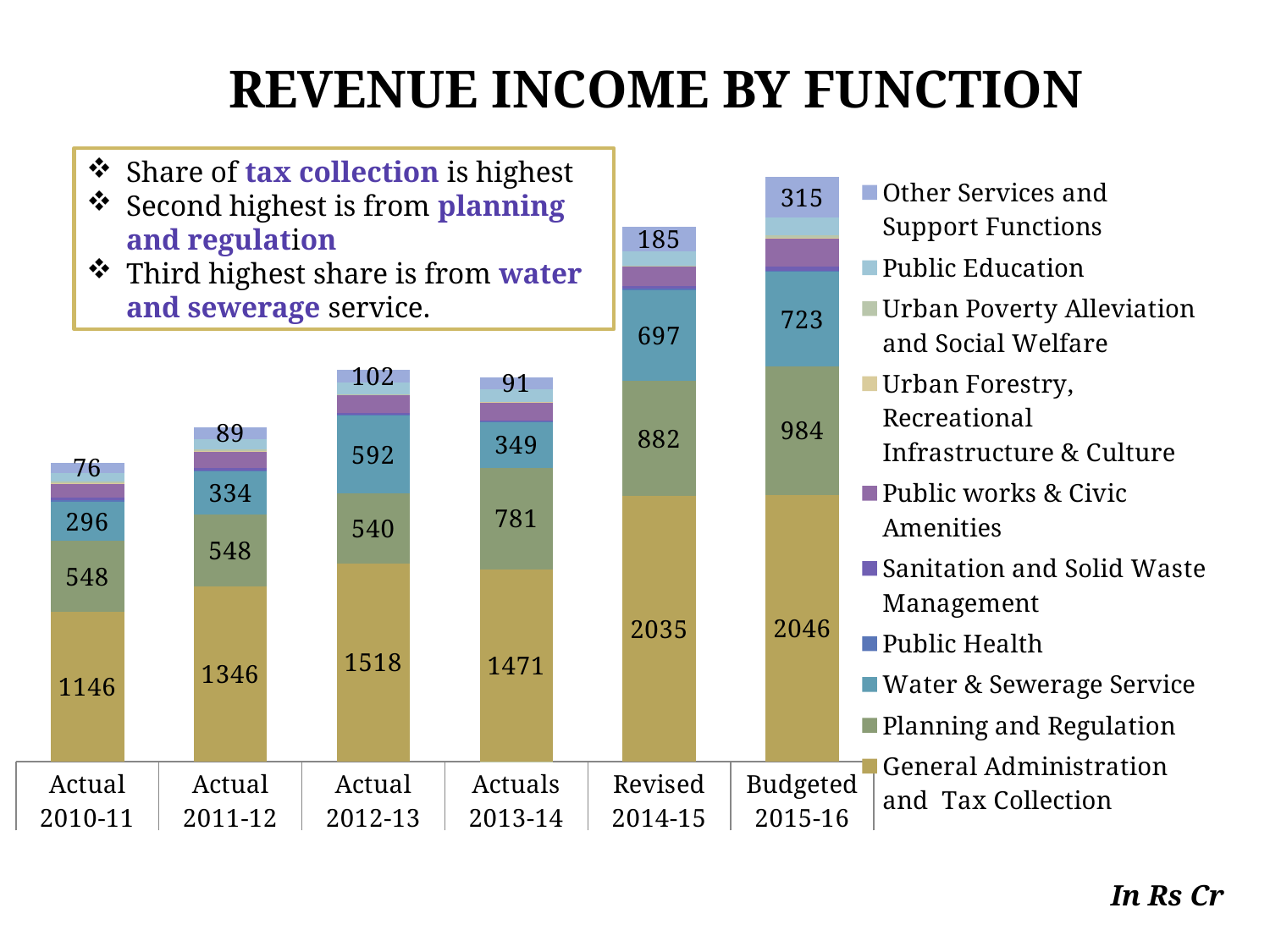
What is the value for General Administration and Tax Collection in Actual 2010-11? 1146 What type of chart is shown on the slide? Stacked bar chart What unit is stated for the values in the chart? In Rs Cr What is the value for Planning and Regulation in Budgeted 2015-16? 984 What is the value for Other Services and Support Functions in Actual 2012-13? 102 In which year is the Other Services and Support Functions value lowest? Actual 2010-11 How many series does the legend list? 10 How many bars (years) are shown on the x axis? 6 Which is larger: Planning and Regulation in Actuals 2013-14 or in Actual 2012-13? Actuals 2013-14 What is the difference between the Water & Sewerage Service values in Actual 2012-13 and Actuals 2013-14? 243 What is the value for Water & Sewerage Service in Revised 2014-15? 697 In which year is the General Administration and Tax Collection value highest? Budgeted 2015-16